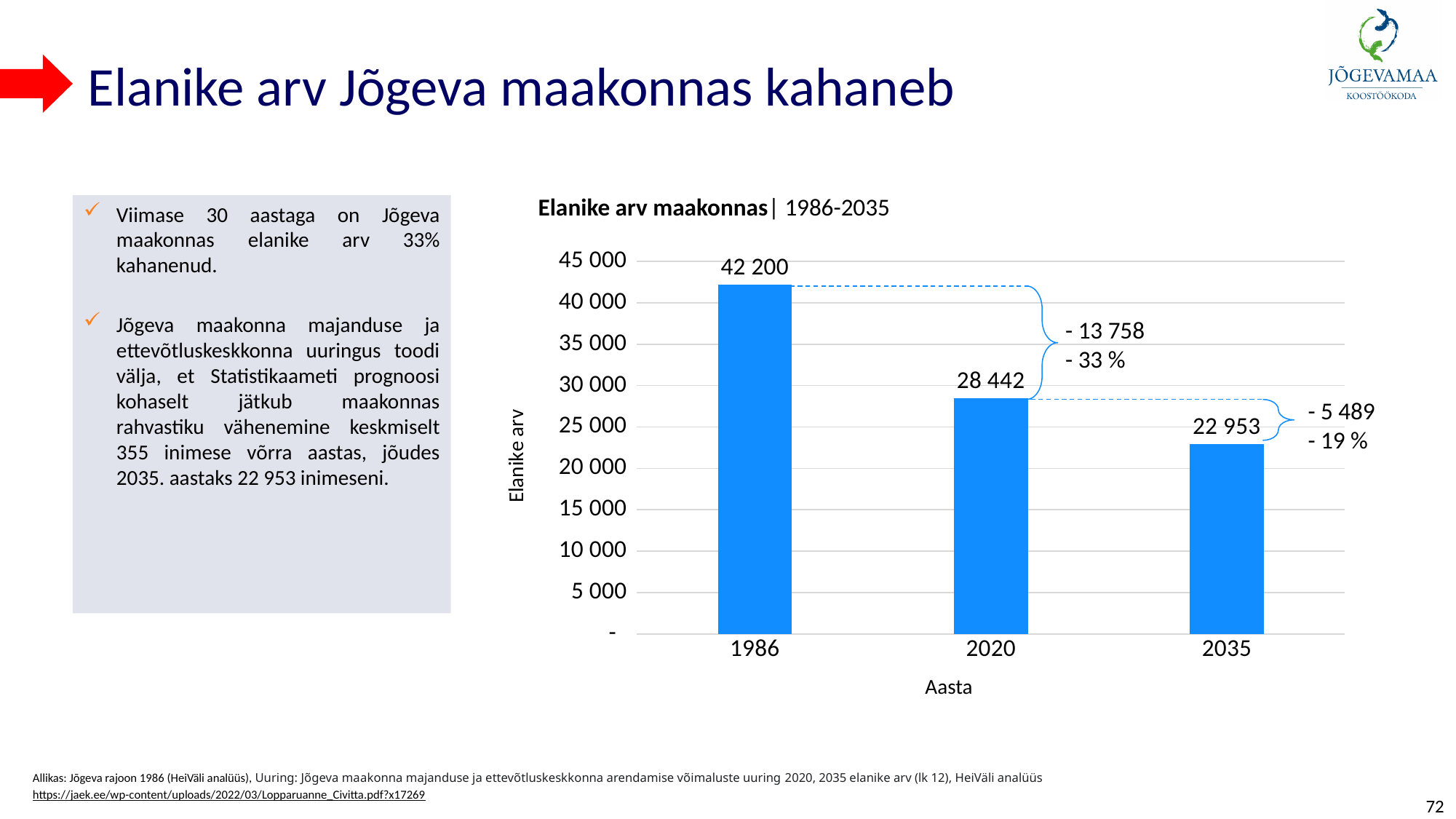
Is the value for 2020 greater or less than 30 000? less Which year has the lowest population value? 2035 What is the population value shown for 2020? 28 442 Which year has the highest population value? 1986 Do the values rise or fall from 1986 to 2035? fall What is the difference between the population values for 2020 and 2035? 5 489 What kind of chart is shown on the slide? bar chart What is the population value shown for 2035? 22 953 What is the difference between the population values for 1986 and 2020? 13 758 Which is larger, the population value for 2020 or for 2035? 2020 How many years are shown on the x axis? 3 What is the population value shown for 1986? 42 200